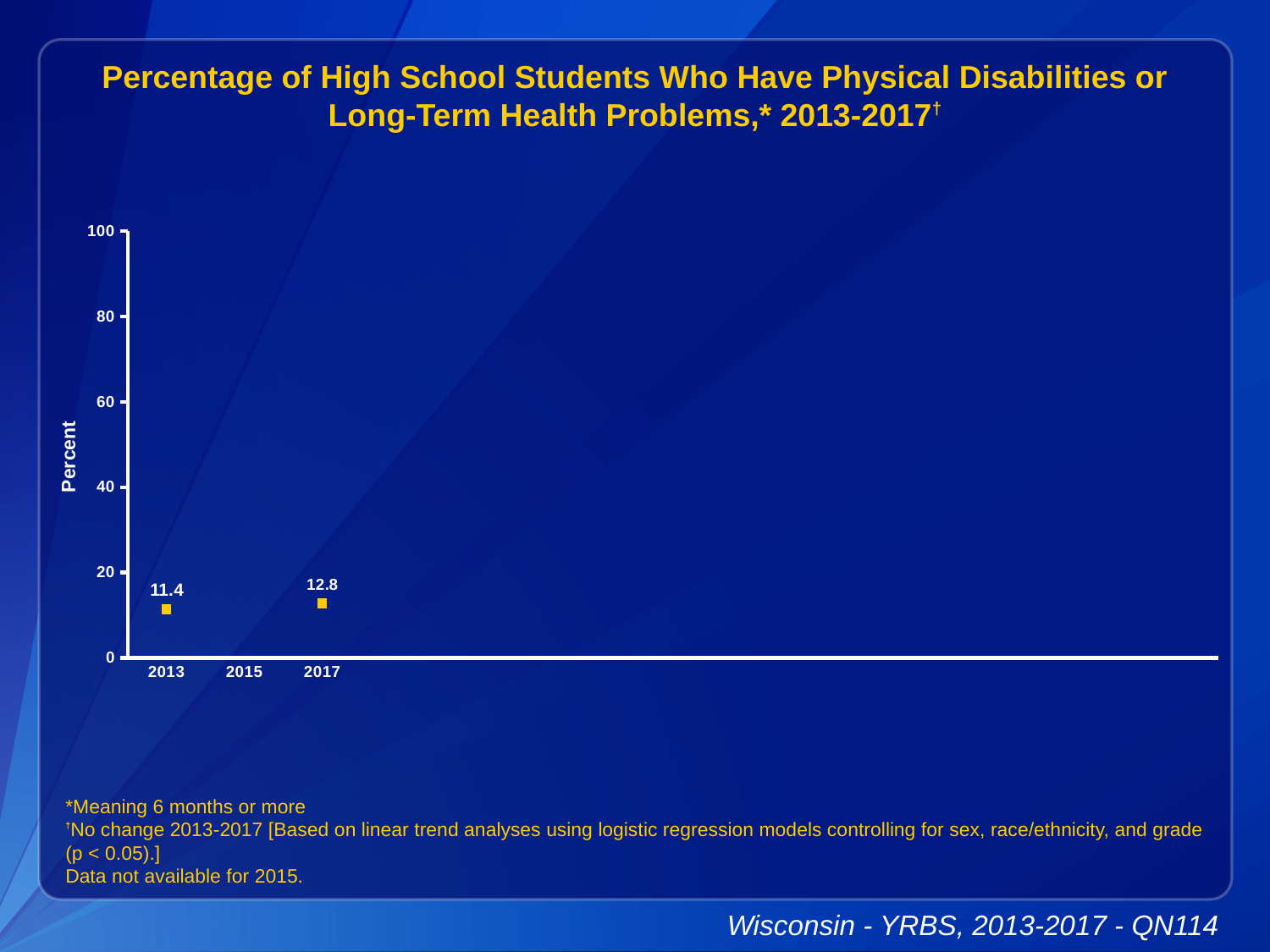
For which year on the x axis is no data point plotted? 2015 What is the value for 2017? 12.8 What is the value for 2013? 11.4 Which year has the highest value? 2017 Do the plotted values rise or fall from 2013 to 2017? rise Which is larger, the value for 2013 or the value for 2017? 2017 What is the difference between the 2017 and 2013 values? 1.4 How many years are labeled on the x axis? 3 Is the value for 2017 greater or less than 20? less What is the label of the y axis? Percent Which year has the lowest plotted value? 2013 How many data points are plotted on the chart? 2